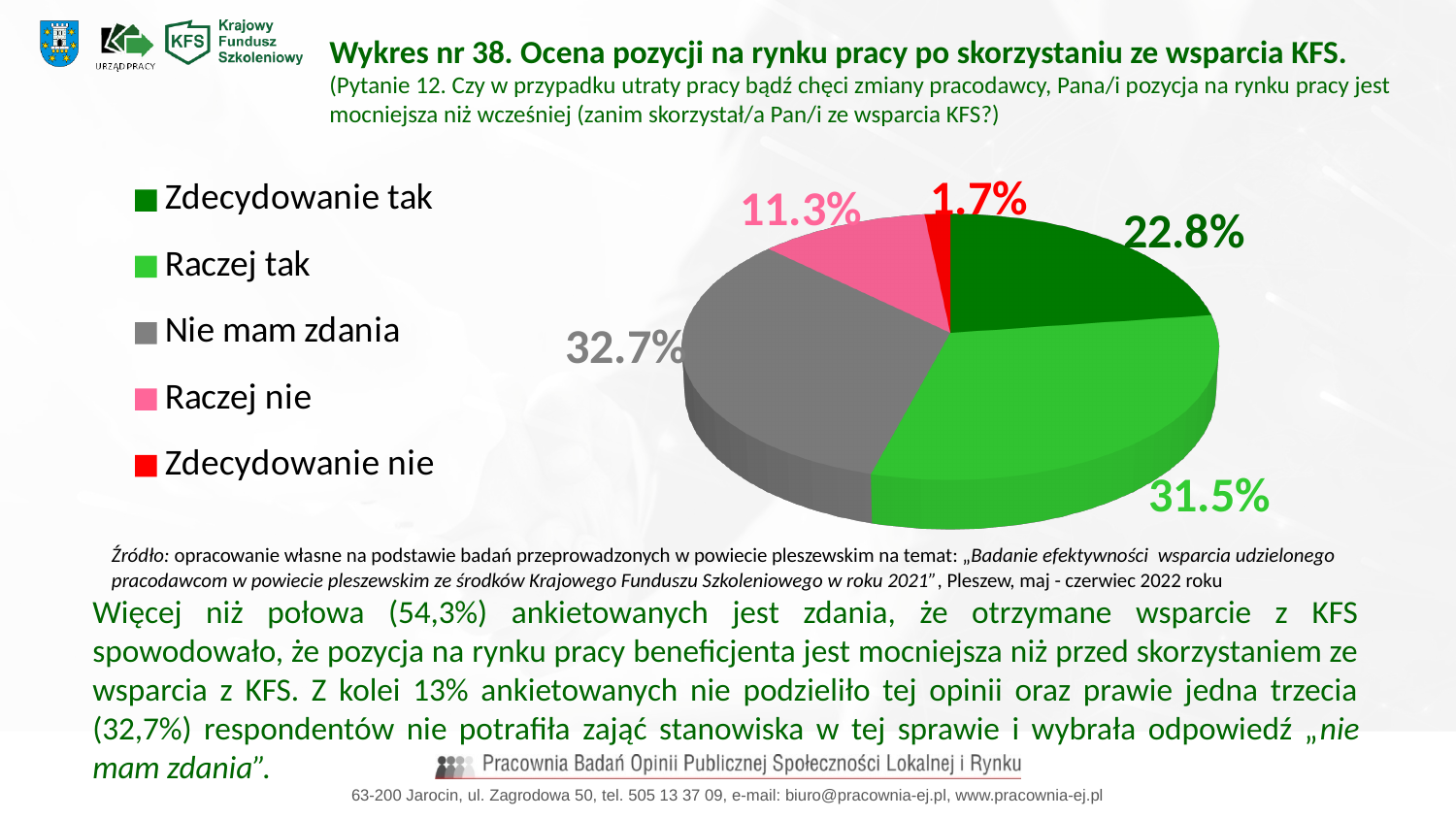
How many answer categories does the legend list? 5 What kind of chart is shown on the slide? pie chart What percentage of respondents answered "Raczej nie"? 11.3% What is the difference in percentage points between "Raczej tak" and "Raczej nie"? 20.2 What percentage of respondents answered "Zdecydowanie nie"? 1.7% What colour is the slice for "Nie mam zdania"? gray What percentage of respondents answered "Nie mam zdania"? 32.7% Which answer category has the largest share of the pie? Nie mam zdania Which is larger: the share for "Zdecydowanie tak" or the share for "Raczej tak"? Raczej tak What percentage of respondents answered "Raczej tak"? 31.5% Which answer category has the smallest share of the pie? Zdecydowanie nie What percentage of respondents answered "Zdecydowanie tak"? 22.8%